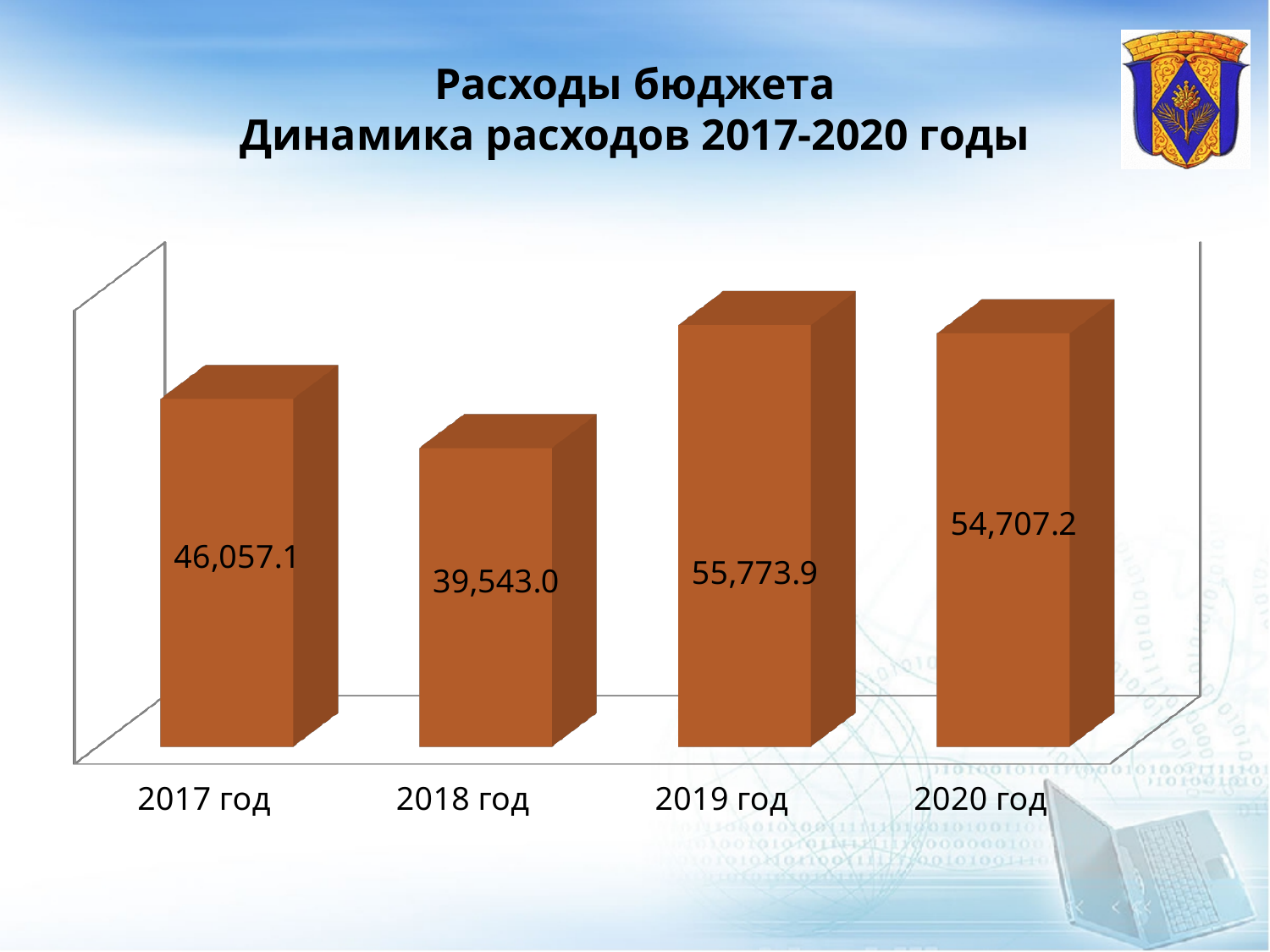
What is the difference between the values for 2017 год and 2018 год? 6,514.1 Which year has the lowest value? 2018 год Does the value rise or fall from 2017 год to 2018 год? Fall Which year has the highest value? 2019 год Which is larger, the value for 2017 год or the value for 2020 год? 2020 год What is the difference between the values for 2019 год and 2018 год? 16,230.9 How many years are shown on the chart? 4 What is the value for 2019 год? 55,773.9 What is the value for 2018 год? 39,543.0 What is the value for 2020 год? 54,707.2 What is the value for 2017 год? 46,057.1 What kind of chart is shown on the slide? Bar chart